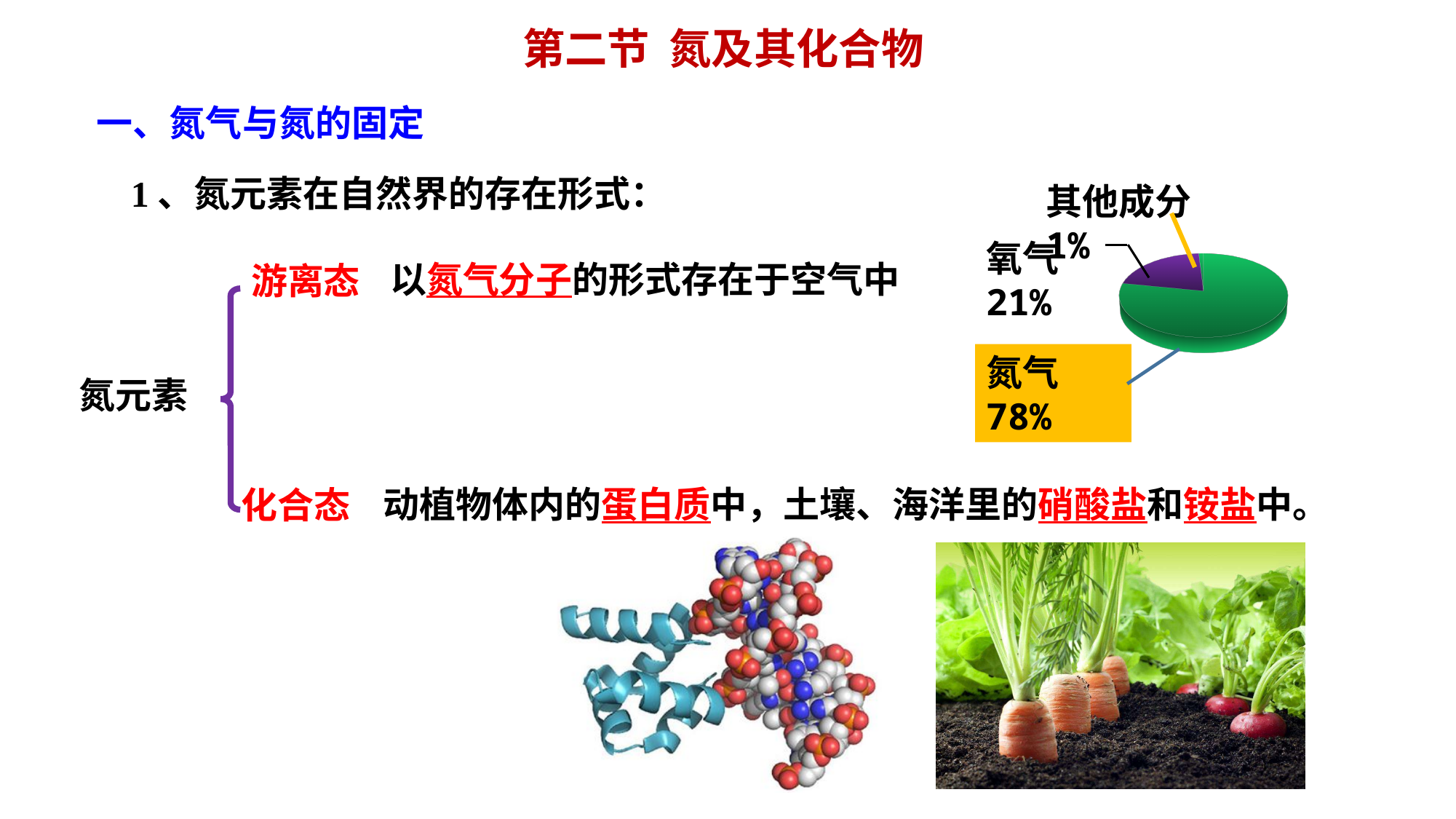
What kind of chart is shown on the slide? pie chart What colour is the 氧气 slice in the pie chart? purple Which slice of the pie chart is the smallest? 其他成分 What is the difference between the shares of 氮气 and 氧气 in the pie chart? 57% How many slices does the pie chart have? 3 What colour is the 氮气 slice in the pie chart? green Which is larger in the pie chart, the share of 氧气 or the share of 其他成分? 氧气 What share of the pie chart does 氮气 (nitrogen) have? 78% Which slice of the pie chart is the largest? 氮气 What share of the pie chart does 氧气 (oxygen) have? 21% What share of the pie chart does 其他成分 (other components) have? 1% What is the difference between the shares of 氧气 and 其他成分 in the pie chart? 20%